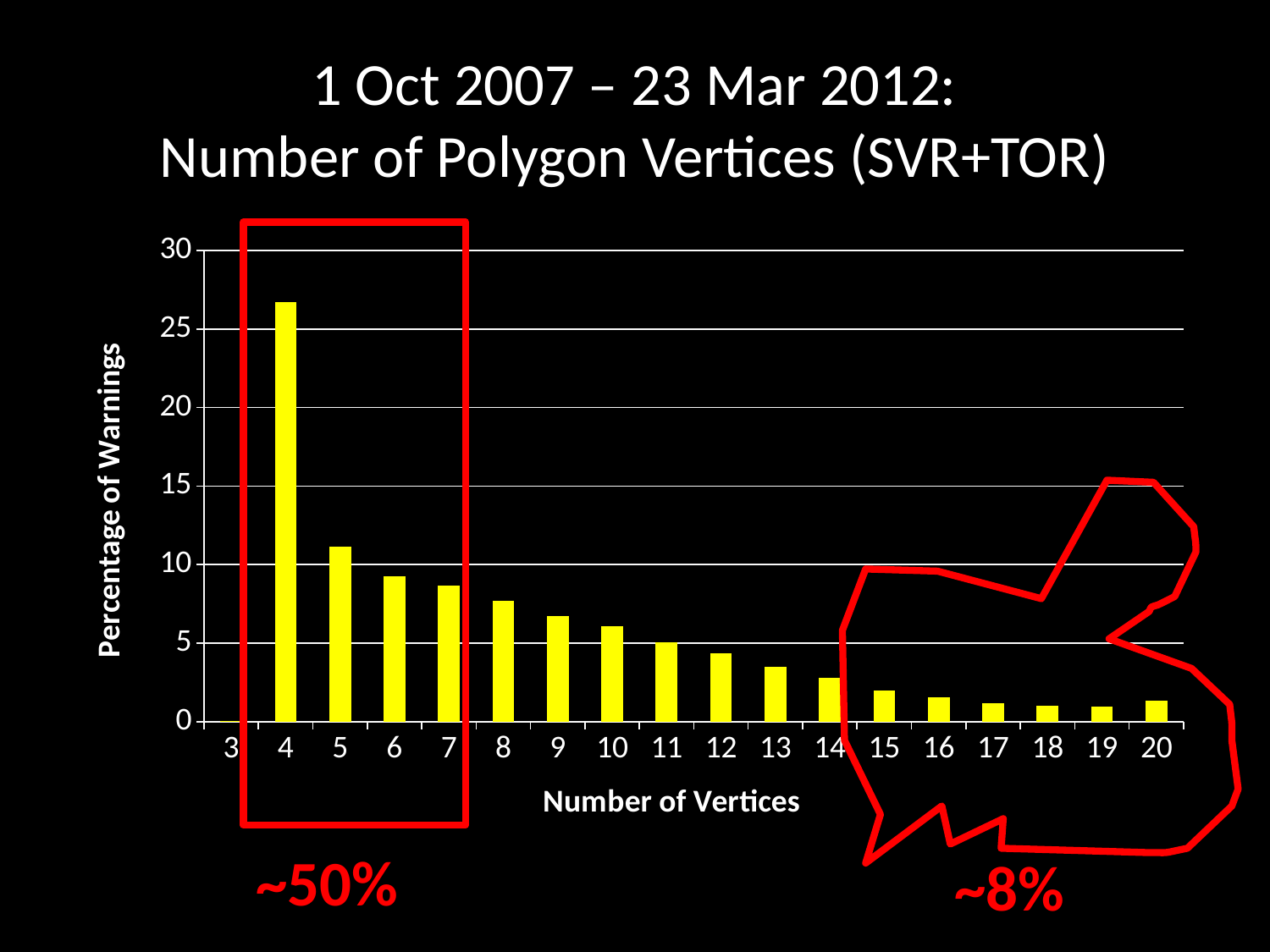
Do the percentages generally rise or fall as the number of vertices increases from 4 to 19? fall Is the percentage of warnings for 8 vertices greater or less than 10? less Which has a higher percentage of warnings, 6 vertices or 10 vertices? 6 vertices How many vertex-count categories are shown on the x axis? 18 Which number of vertices has the highest percentage of warnings? 4 What is the label on the y axis of the chart? Percentage of Warnings Is the percentage of warnings for 4 vertices greater or less than 25? greater Is the percentage of warnings for 5 vertices greater or less than 10? greater Which has a higher percentage of warnings, 12 vertices or 15 vertices? 12 vertices What kind of chart is shown on the slide? bar chart What approximate share is annotated in red below the box around vertices 4 to 7? ~50%